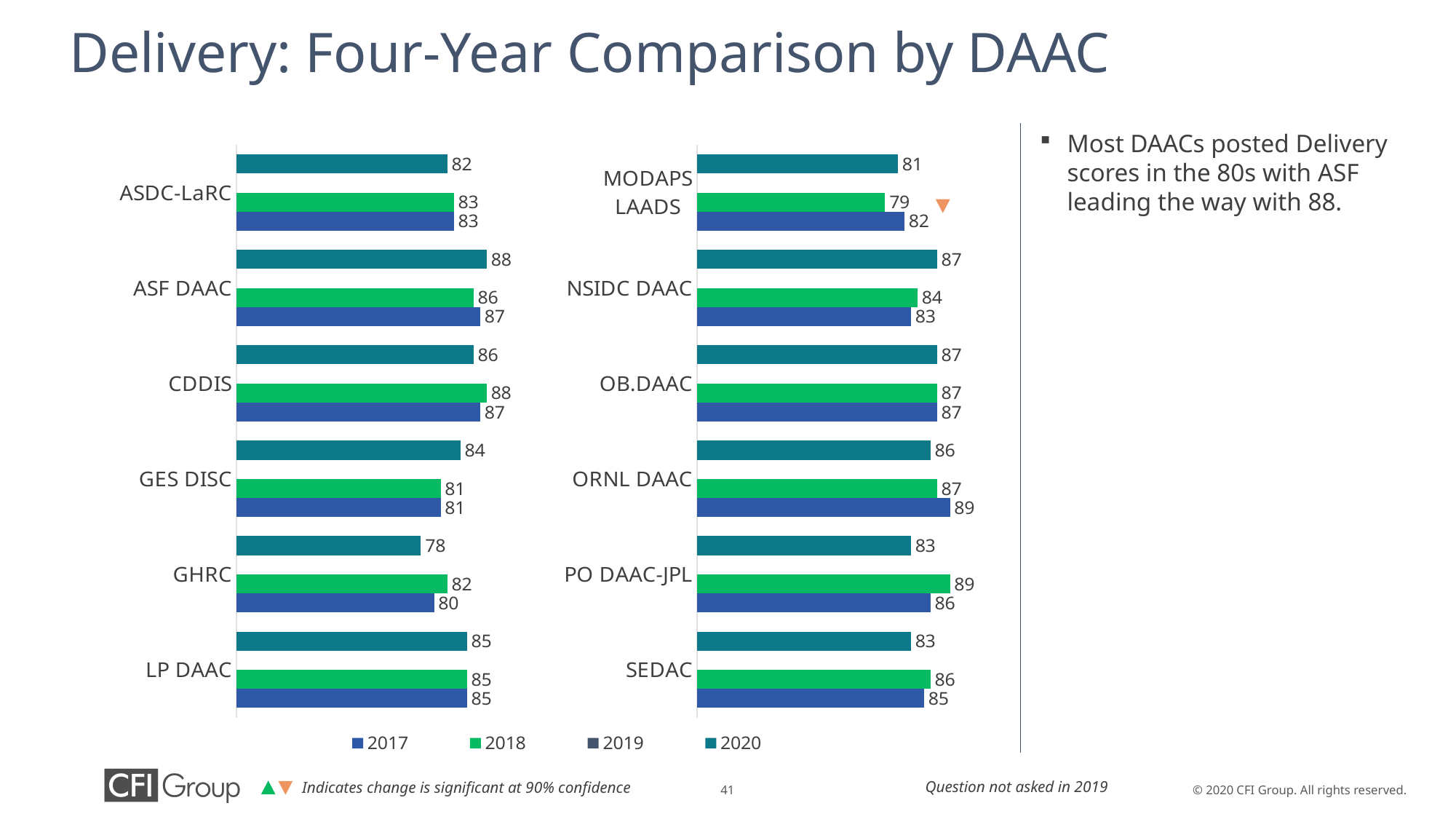
In the left chart, what is the 2017 Delivery score for GHRC? 80 In the left chart, what is the difference between the 2020 and 2018 Delivery scores for GES DISC? 3 What type of chart is used on this slide? bar chart In the right chart, is the 2017 Delivery score for ORNL DAAC higher or lower than its 2020 score? higher In the right chart, what is the 2018 Delivery score for PO DAAC-JPL? 89 How many DAACs are shown in the left chart? 6 In the left chart, which DAAC has the highest 2020 Delivery score? ASF DAAC How many series does the legend list? 4 In the right chart, what is the difference between the 2018 and 2020 Delivery scores for PO DAAC-JPL? 6 In the right chart, which DAAC has the lowest 2018 Delivery score? MODAPS LAADS In the left chart, what is the 2020 Delivery score for ASF DAAC? 88 In the left chart, which DAAC has the lowest 2020 Delivery score? GHRC